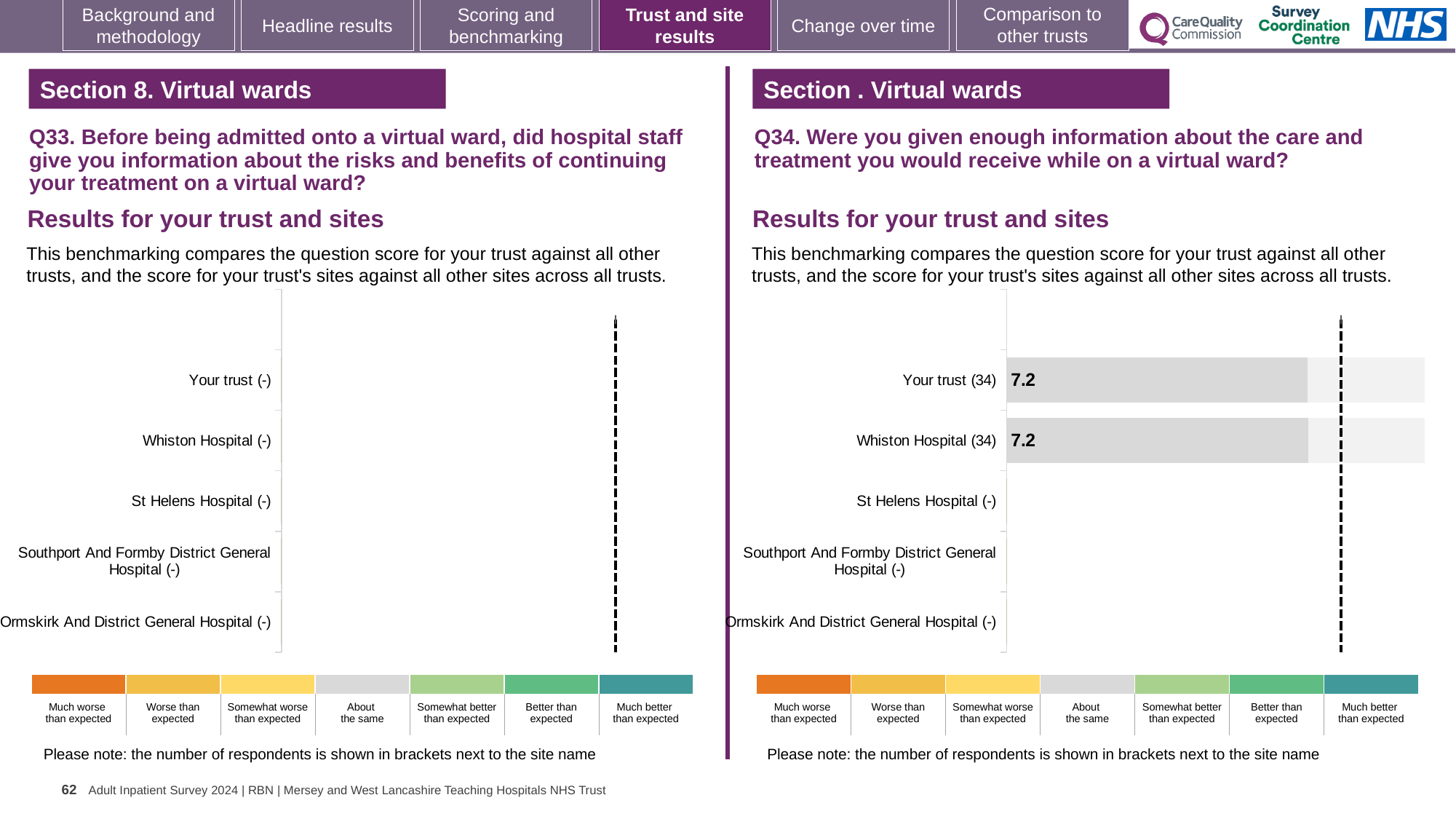
On the Q34 chart (right), what is the score for Your trust? 7.2 On the Q34 chart (right), which category is listed last (at the bottom) on the vertical axis? Ormskirk And District General Hospital (-) On the Q34 chart (right), what is the difference between the score for Your trust and the score for Whiston Hospital? 0 How many benchmark categories does the colour key below each chart show? 7 On the Q33 chart (left), how many site/trust categories are listed on the vertical axis? 5 On the Q34 chart (right), how many respondents are shown in brackets for Whiston Hospital? 34 On the Q34 chart (right), what is the score for Whiston Hospital? 7.2 On the Q34 chart (right), how many categories have a bar plotted? 2 What kind of chart is used on the Q34 (right) side of the slide? Bar chart On the Q34 chart (right), how many respondents are shown in brackets for Your trust? 34 On the Q34 chart (right), how many site/trust categories are listed on the vertical axis? 5